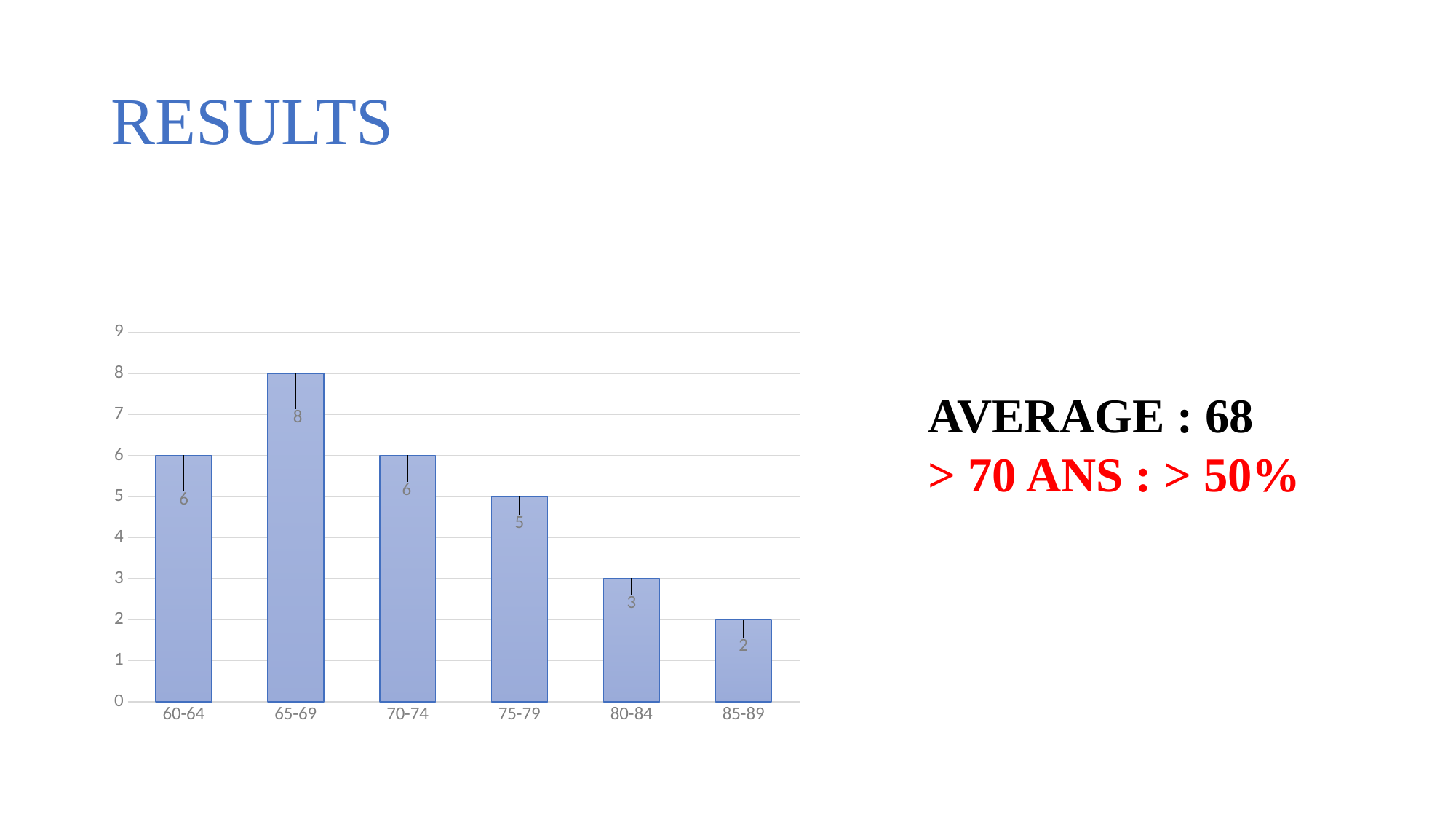
What is the value for the 85-89 category? 2 What is the difference between the values for 65-69 and 80-84? 5 What is the value for the 75-79 category? 5 What is the highest value shown on the y axis? 9 Do the values rise or fall from 65-69 to 85-89? fall What kind of chart is shown on the slide? bar chart How many categories are shown on the x axis? 6 What is the total of all the bar values in the chart? 30 Which is larger, the value for 70-74 or the value for 75-79? 70-74 Which category has the lowest value? 85-89 What is the value for the 65-69 category? 8 Which category has the highest value? 65-69